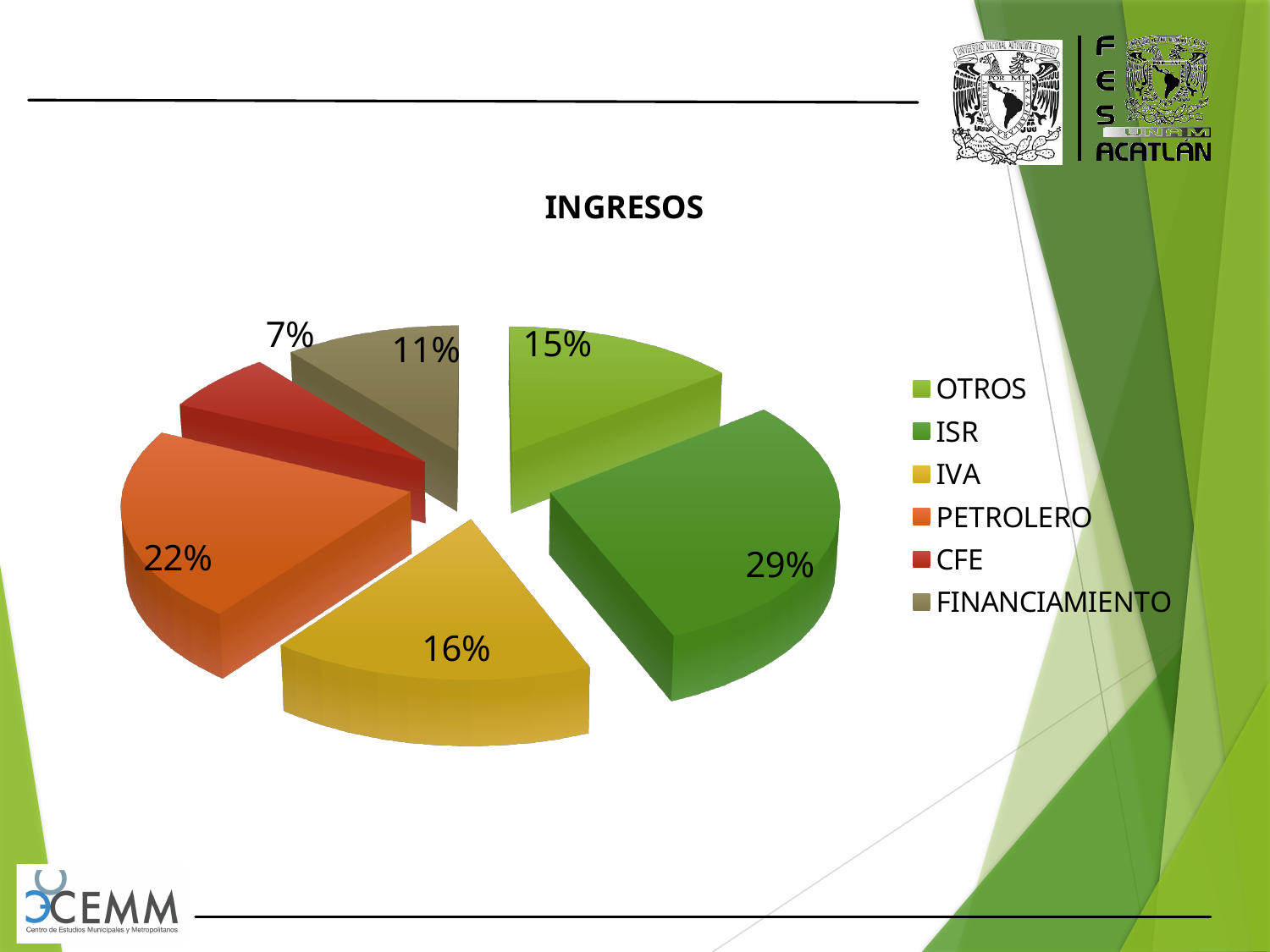
What share of the pie does ISR represent? 29% What share of the pie does FINANCIAMIENTO represent? 11% What is the value shown for OTROS? 15% What share of the pie does PETROLERO represent? 22% What kind of chart is shown on the slide? Pie chart What is the difference between the shares of ISR and PETROLERO? 7% Which category has the smallest slice of the pie? CFE What is the title of the chart? INGRESOS What is the value shown for IVA? 16% How many categories does the legend list? 6 Which category has the largest slice of the pie? ISR